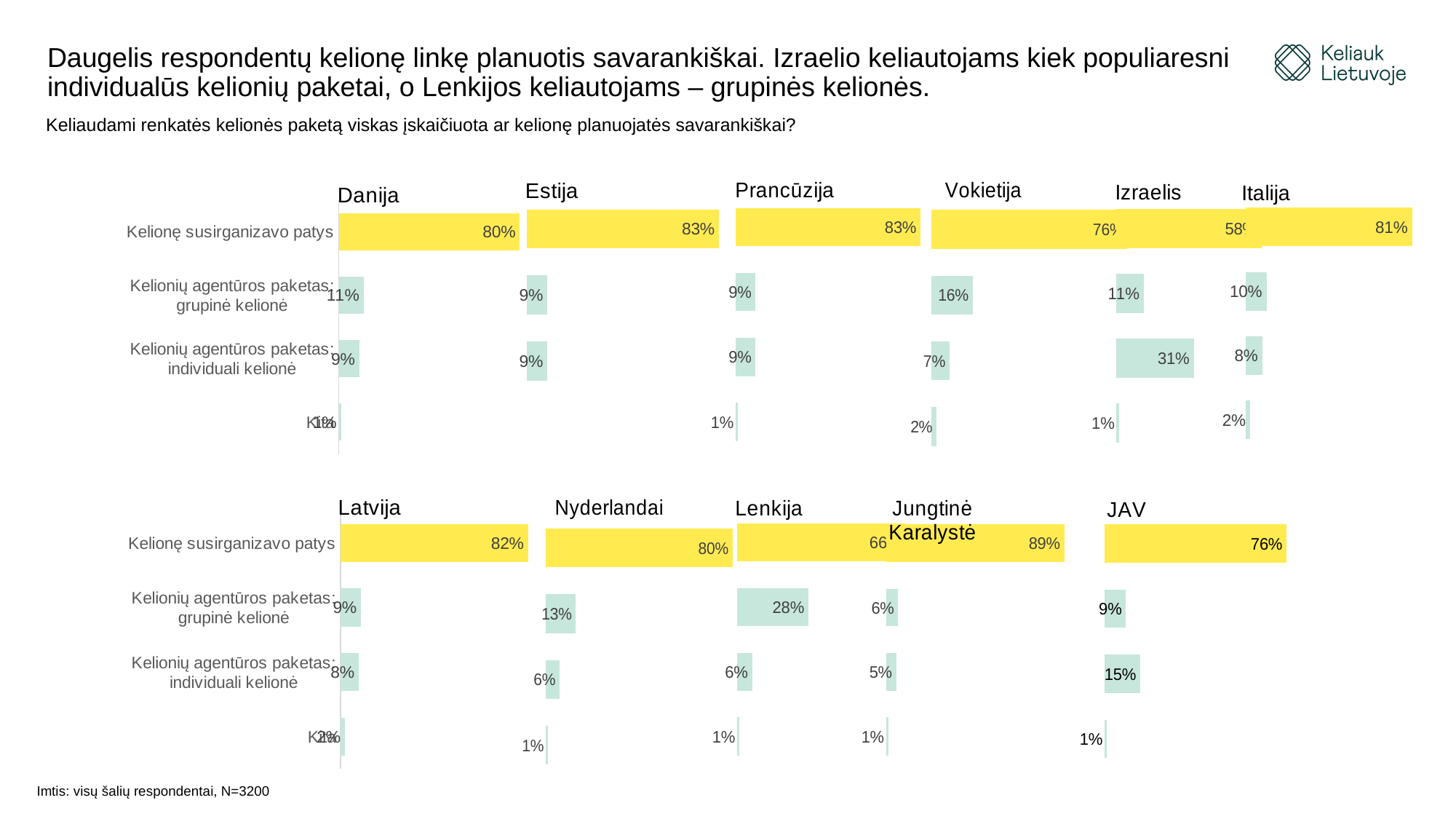
In the JAV chart, what is the value for "Kelionių agentūros paketas: individuali kelionė"? 15% In the Izraelis chart, what is the value for "Kelionių agentūros paketas: individuali kelionė"? 31% In the Lenkija chart, what is the value for "Kelionių agentūros paketas: grupinė kelionė"? 28% In the Jungtinė Karalystė chart, what is the value for "Kelionę susirganizavo patys"? 89% Which is larger: the "Kelionių agentūros paketas: grupinė kelionė" value in the Lenkija chart or in the Nyderlandai chart? Lenkija How many categories does each country's chart show? 4 What is the difference between the "Kelionę susirganizavo patys" value in the Jungtinė Karalystė chart and in the Italija chart? 8 percentage points In the Vokietija chart, what is the value for "Kelionių agentūros paketas: grupinė kelionė"? 16% In the Izraelis chart, which category has the highest value? Kelionę susirganizavo patys What kind of chart is used for each country on the slide? Bar chart In the Nyderlandai chart, what is the value for "Kelionių agentūros paketas: grupinė kelionė"? 13% In the Izraelis chart, what is the difference between "Kelionių agentūros paketas: individuali kelionė" and "Kelionių agentūros paketas: grupinė kelionė"? 20 percentage points